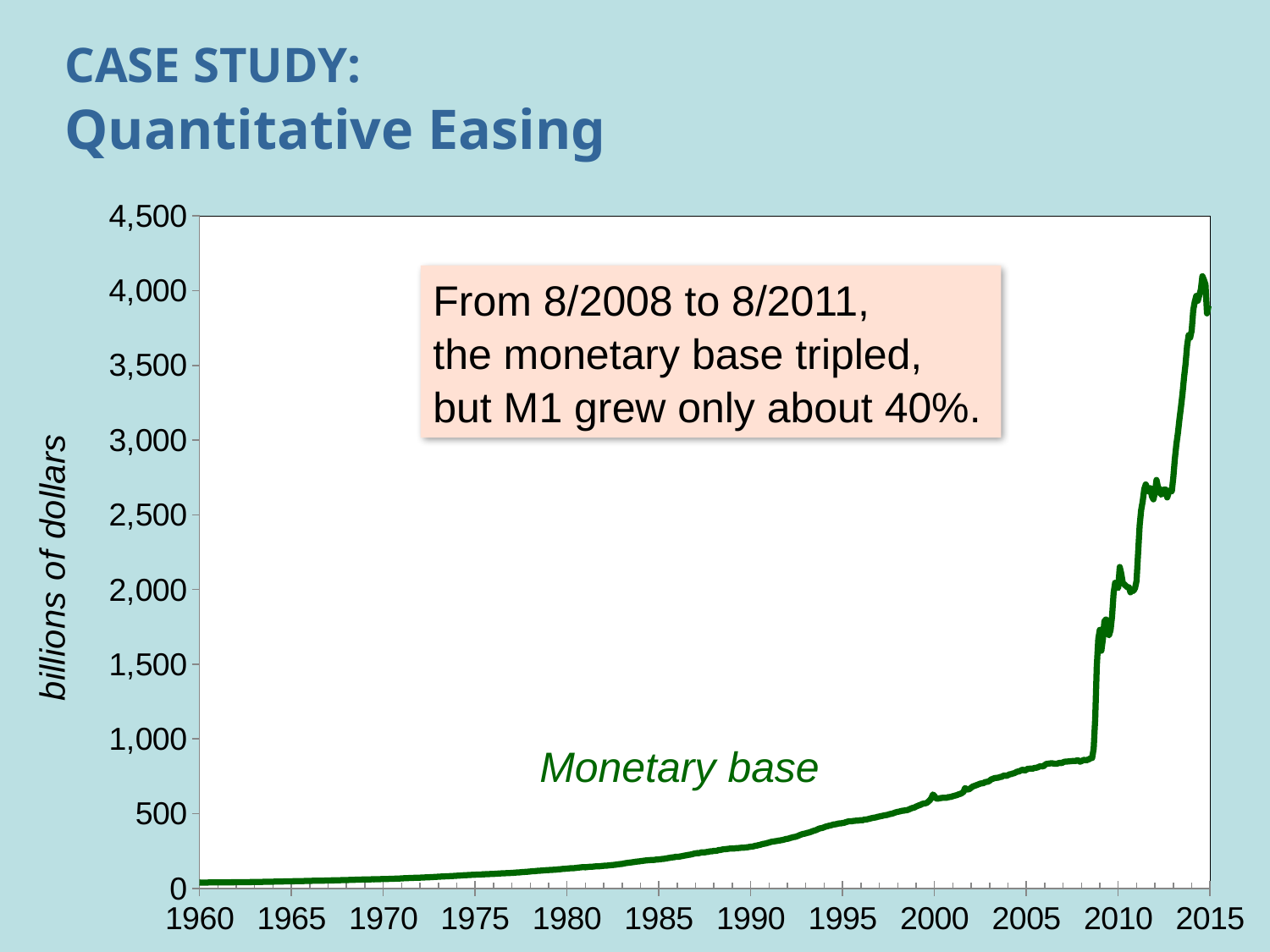
Which year labeled on the x axis has the lowest monetary base? 1960 Which is larger, the monetary base in 2010 or in 2000? 2010 Does the monetary base generally rise or fall from 1960 to 2015? rise What series is plotted on the chart? Monetary base Is the value of the monetary base in 2015 greater or less than 3,500? greater How many year labels are shown on the x axis? 12 Is the value of the monetary base in 1990 greater or less than 500? less Is the value of the monetary base in 2000 greater or less than 1,000? less What kind of chart is shown on the slide? line chart What is the label on the vertical axis of the chart? billions of dollars